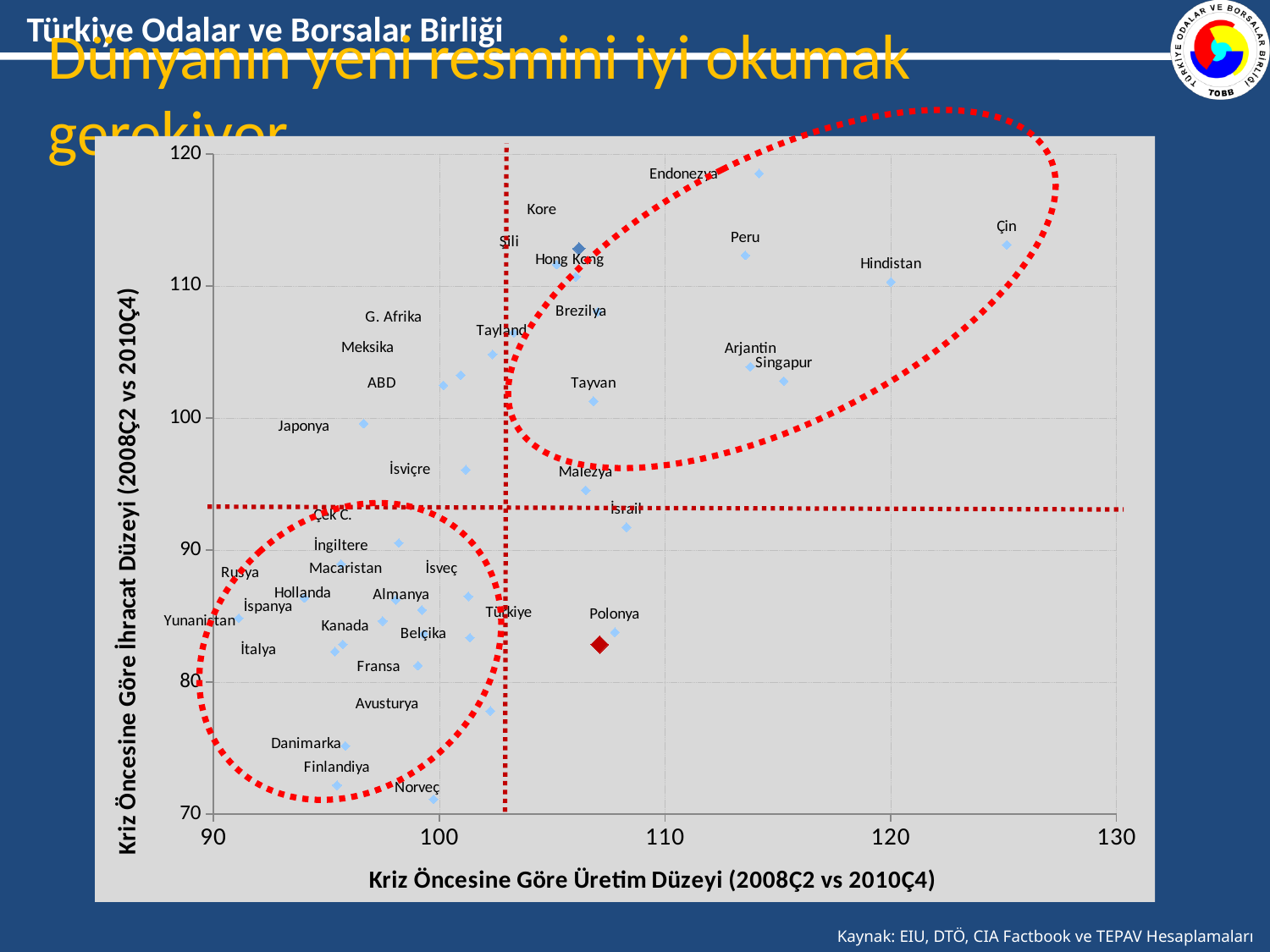
Is the horizontal-axis value for Çin greater or less than 120? greater Is the vertical-axis value for Norveç greater or less than 80? less Is the horizontal-axis value for Yunanistan greater or less than 100? less Which has the larger vertical-axis value, Endonezya or Türkiye? Endonezya What kind of chart is shown on the slide? scatter chart Which country has the highest value on the horizontal axis (Kriz Öncesine Göre Üretim Düzeyi)? Çin What is the title of the horizontal axis of the chart? Kriz Öncesine Göre Üretim Düzeyi (2008Ç2 vs 2010Ç4) Which country has the highest value on the vertical axis (Kriz Öncesine Göre İhracat Düzeyi)? Endonezya Which has the larger horizontal-axis value, Çin or Hindistan? Çin